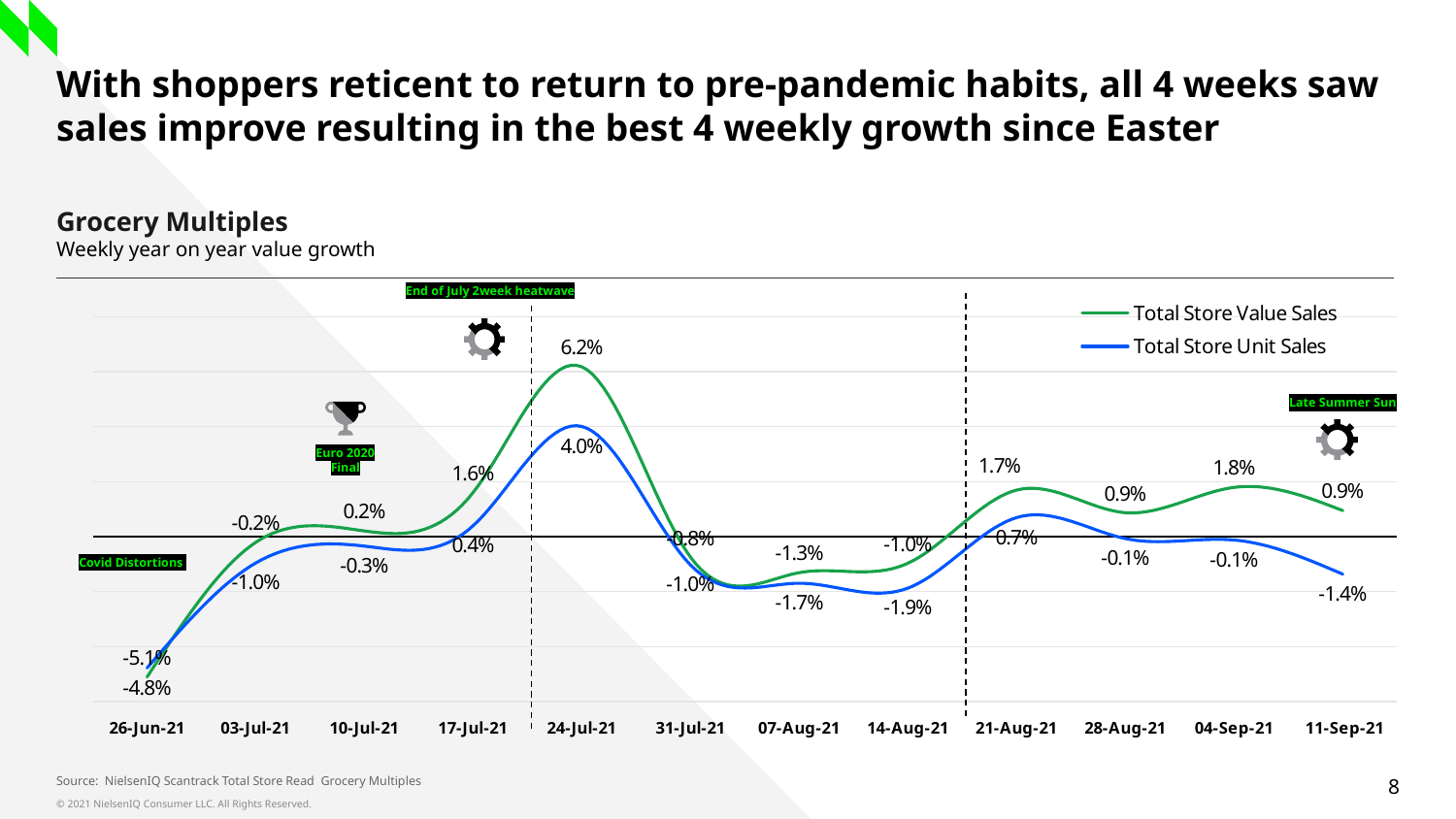
What type of chart is shown on the slide? Line chart On which date is Total Store Unit Sales at its lowest? 26-Jun-21 What is the Total Store Unit Sales growth for 24-Jul-21? 4.0% Which is larger for Total Store Value Sales: 28-Aug-21 or 04-Sep-21? 04-Sep-21 What is the Total Store Unit Sales growth for 11-Sep-21? -1.4% What is the difference between Total Store Value Sales and Total Store Unit Sales on 24-Jul-21? 2.2 percentage points How many series does the legend list? 2 What is the Total Store Value Sales growth for 04-Sep-21? 1.8% On which date does Total Store Value Sales reach its highest value? 24-Jul-21 What is the Total Store Value Sales growth for 24-Jul-21? 6.2% How many dates are plotted along the x axis? 12 Does Total Store Value Sales rise or fall from 24-Jul-21 to 07-Aug-21? Fall